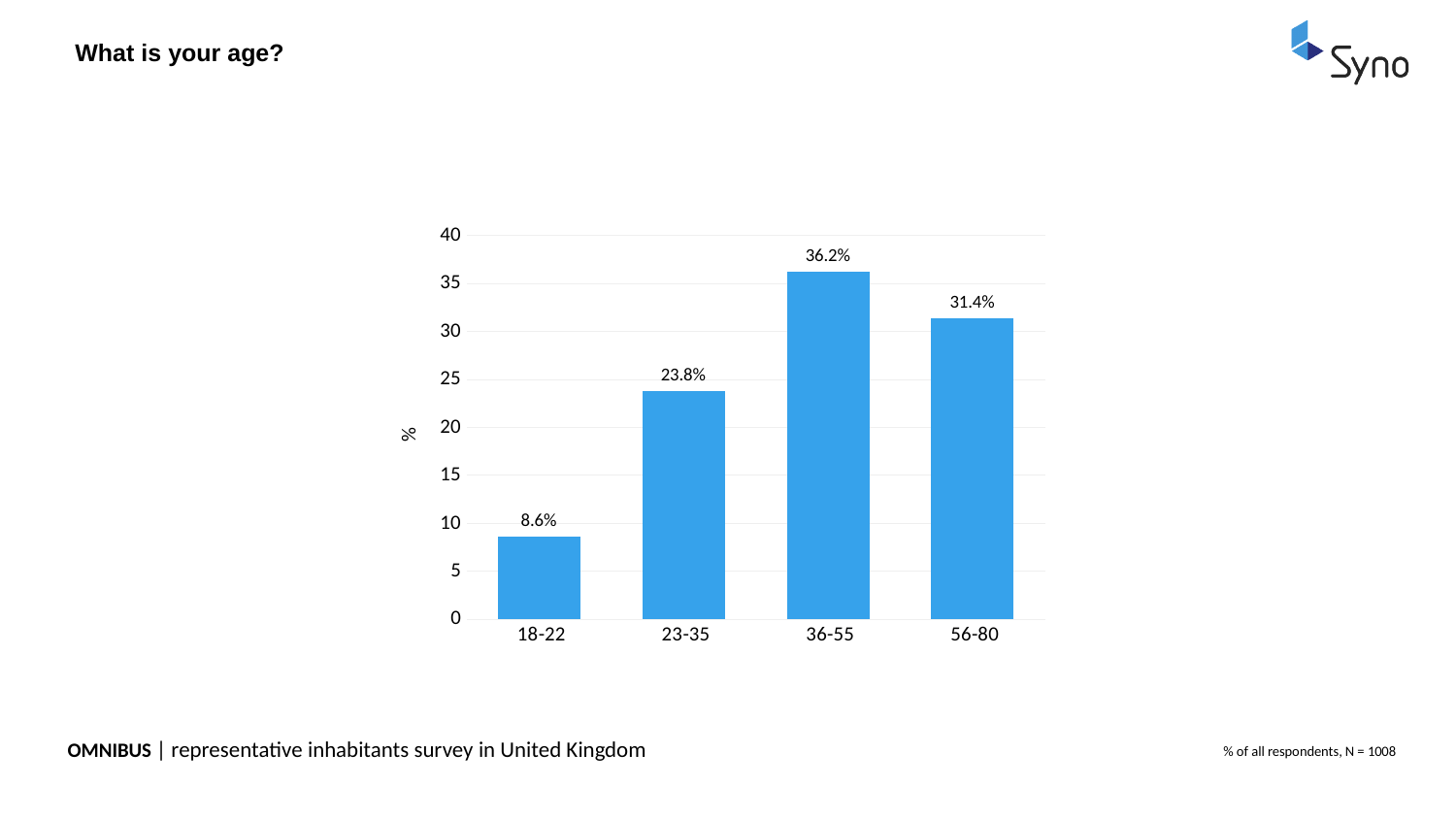
What is the difference between the 23-35 and 18-22 age groups? 15.2% Which age group has the lowest share of respondents? 18-22 Which age group has the highest share of respondents? 36-55 Which is larger, the value for 23-35 or the value for 56-80? 56-80 How many age groups are shown in the chart? 4 What is the value for the 18-22 age group? 8.6% What percentage of respondents are aged 36-55? 36.2% Is the value for 23-35 greater or less than 25? less What is the label on the vertical axis of the chart? % What percentage of respondents are aged 56-80? 31.4% What is the difference between the 36-55 and 56-80 age groups? 4.8% What kind of chart is shown on the slide? bar chart